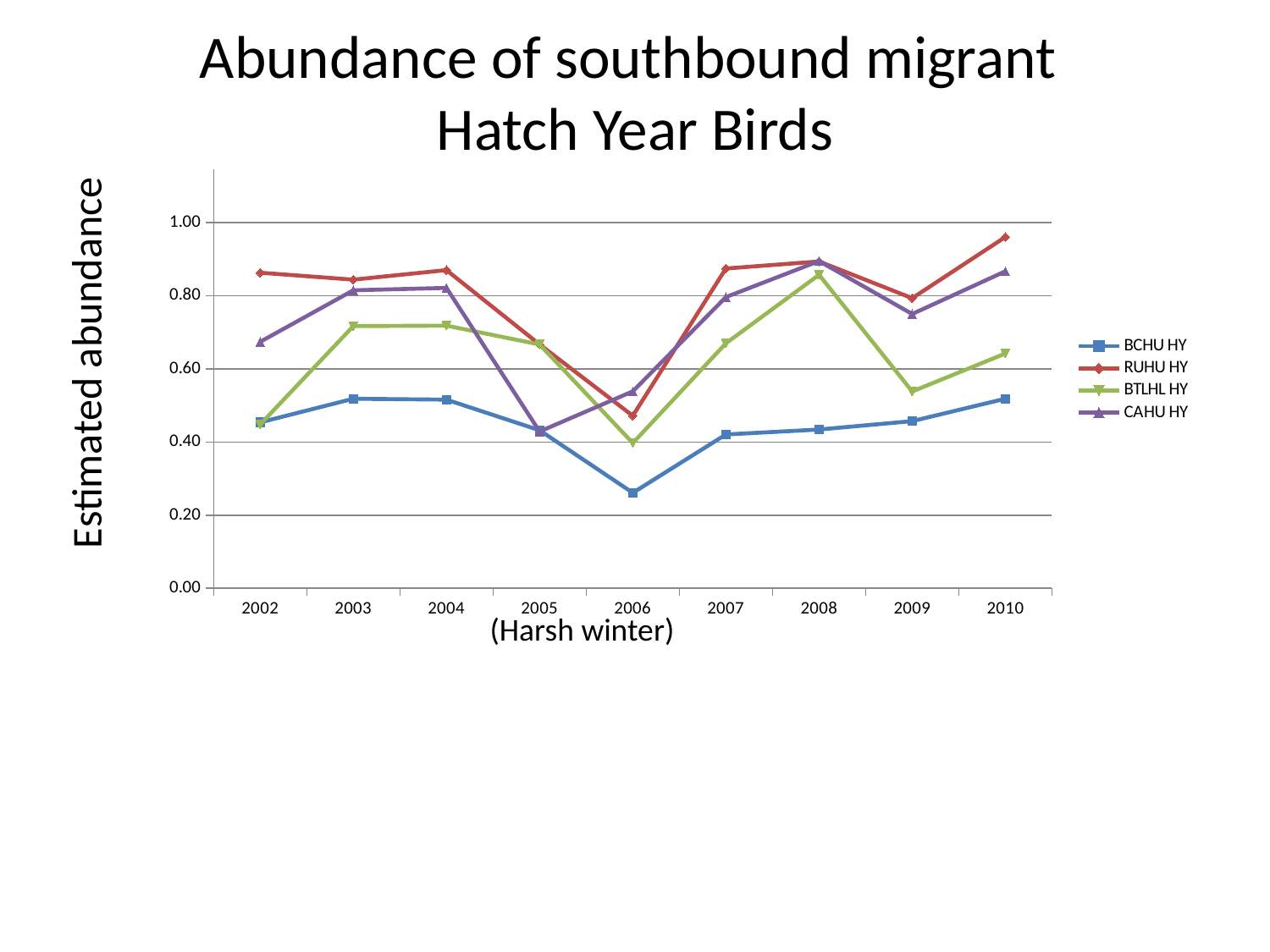
In which year is the BCHU HY series at its lowest? 2006 What kind of chart is shown on the slide? line chart In 2009, which is larger: BTLHL HY or CAHU HY? CAHU HY In which year is the BTLHL HY series at its highest? 2008 Is the value for RUHU HY in 2010 greater or less than 0.80? greater How many years are plotted along the x axis? 9 How many series does the legend list? 4 In which year is the RUHU HY series at its highest? 2010 In which year is the CAHU HY series at its lowest? 2005 Is the value for BCHU HY in 2006 greater or less than 0.40? less What is the label on the y axis? Estimated abundance In 2006, which is larger: RUHU HY or BCHU HY? RUHU HY